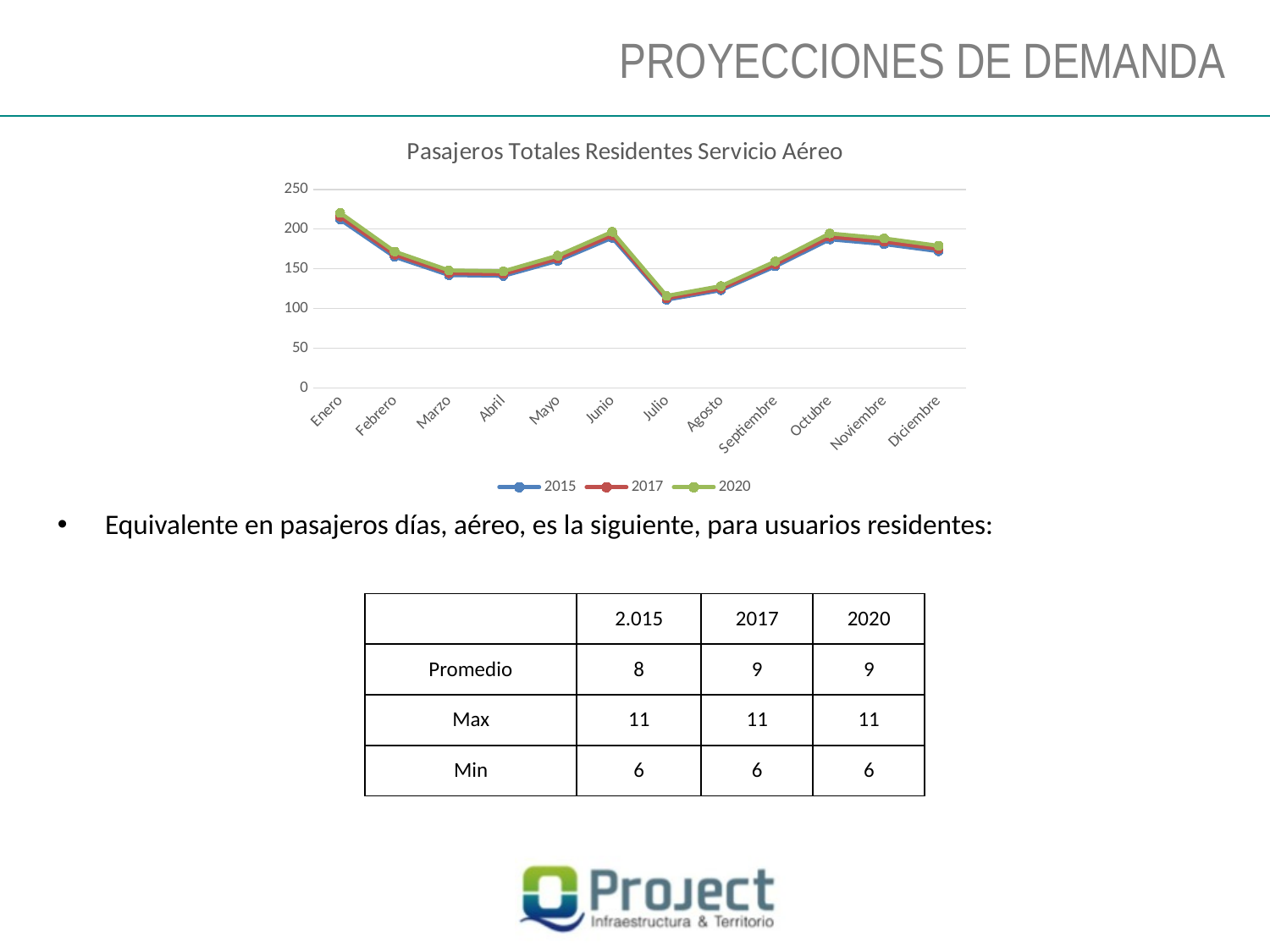
Which month has the lowest value for the 2015 series? Julio Is the value for Agosto in the 2017 series greater or less than 100? greater Is the value for Enero in the 2020 series greater or less than 200? greater Is the value for Julio in the 2015 series greater or less than 150? less Which is larger for the 2017 series, the value for Enero or the value for Julio? Enero What are the three series named in the chart legend? 2015, 2017, 2020 Do the values of the 2015 series rise or fall from Enero to Abril? fall What kind of chart is shown under the title "Pasajeros Totales Residentes Servicio Aéreo"? line chart How many months are plotted along the x axis of the chart? 12 Do the values of the 2020 series rise or fall from Julio to Octubre? rise Which month has the highest value for the 2020 series? Enero How many series does the legend of the chart list? 3